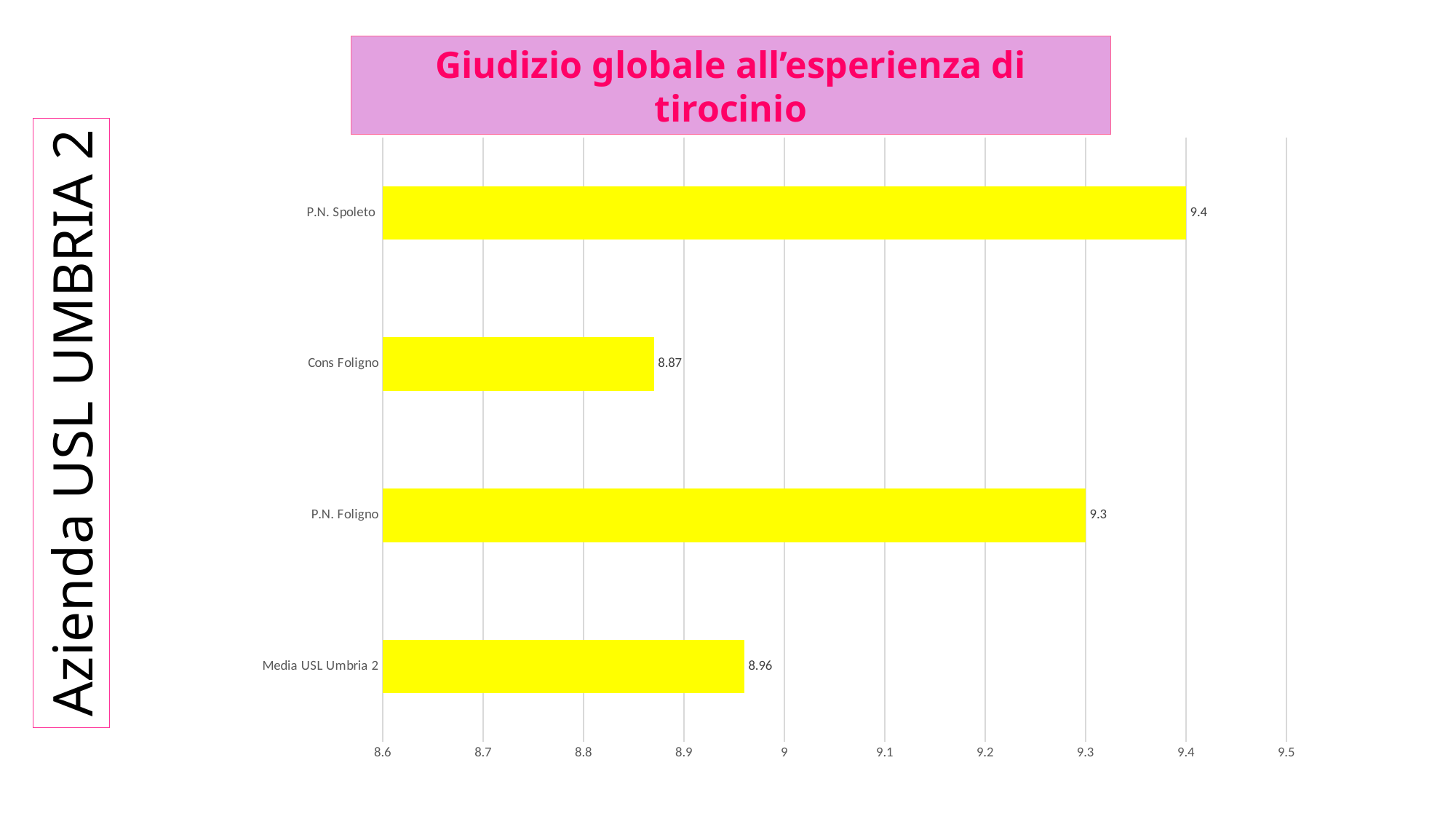
What is the value for P.N. Foligno? 9.3 Which is larger, the value for P.N. Foligno or the value for Cons Foligno? P.N. Foligno Is the value for Media USL Umbria 2 greater or less than 9? less What is the value for Cons Foligno? 8.87 What is the difference between the values for P.N. Foligno and Media USL Umbria 2? 0.34 How many categories are shown in the chart? 4 What is the value for P.N. Spoleto? 9.4 What is the value for Media USL Umbria 2? 8.96 What is the difference between the values for P.N. Spoleto and Cons Foligno? 0.53 Which category has the highest value? P.N. Spoleto Which category has the lowest value? Cons Foligno What is the title of the chart? Giudizio globale all'esperienza di tirocinio